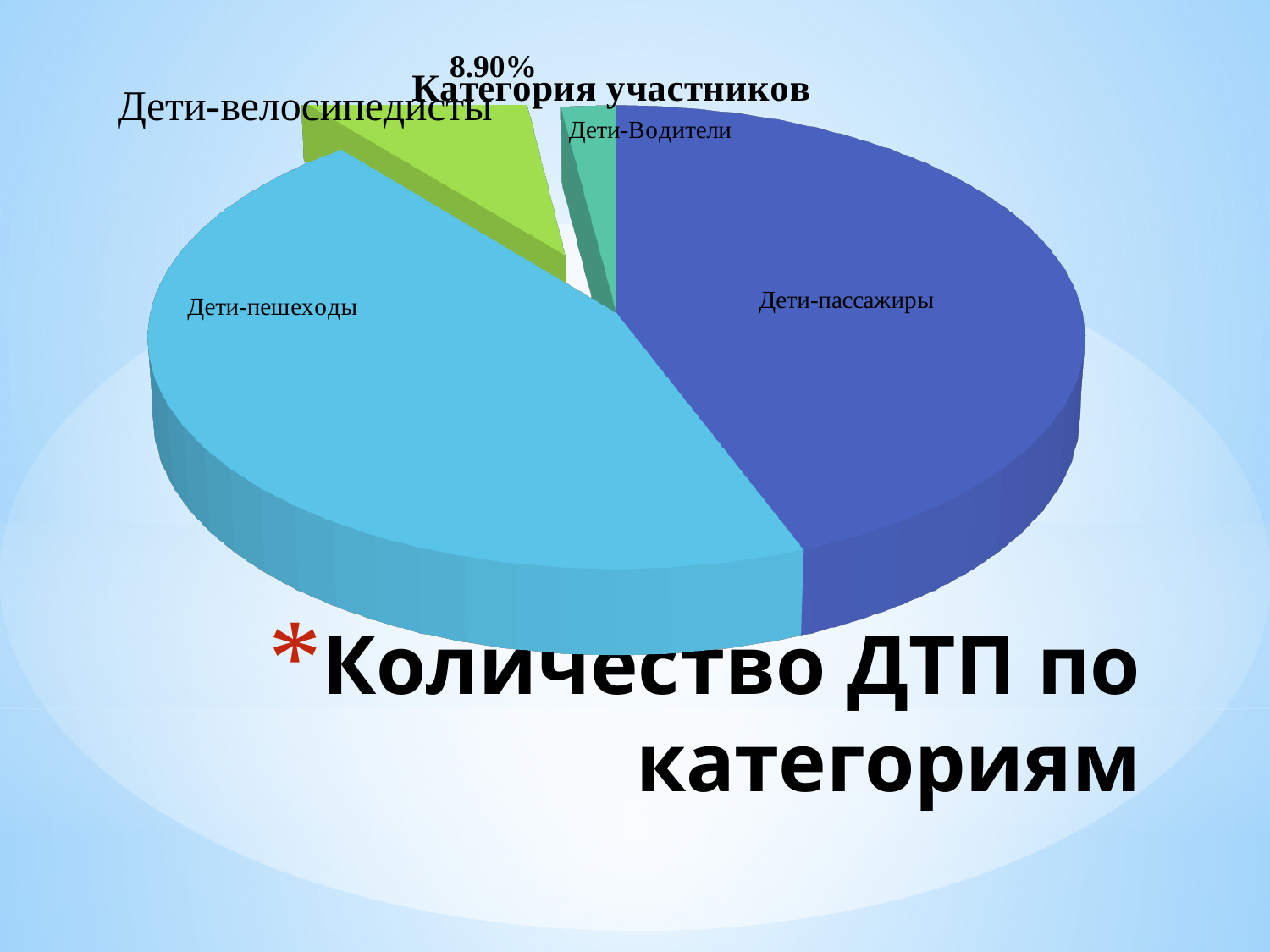
What kind of chart is shown on the slide? pie chart Which category's slice carries the only printed percentage label? Дети-велосипедисты What share of the pie is labelled for Дети-велосипедисты? 8.90% Which category has the smallest slice of the pie? Дети-Водители Which slice is larger: Дети-велосипедисты or Дети-Водители? Дети-велосипедисты What is the title of the chart? Категория участников How many categories (slices) does the pie chart have? 4 Which slice is larger: Дети-пешеходы or Дети-Водители? Дети-пешеходы Which category is shown in green on the pie chart? Дети-велосипедисты Which slice is larger: Дети-пассажиры or Дети-велосипедисты? Дети-пассажиры